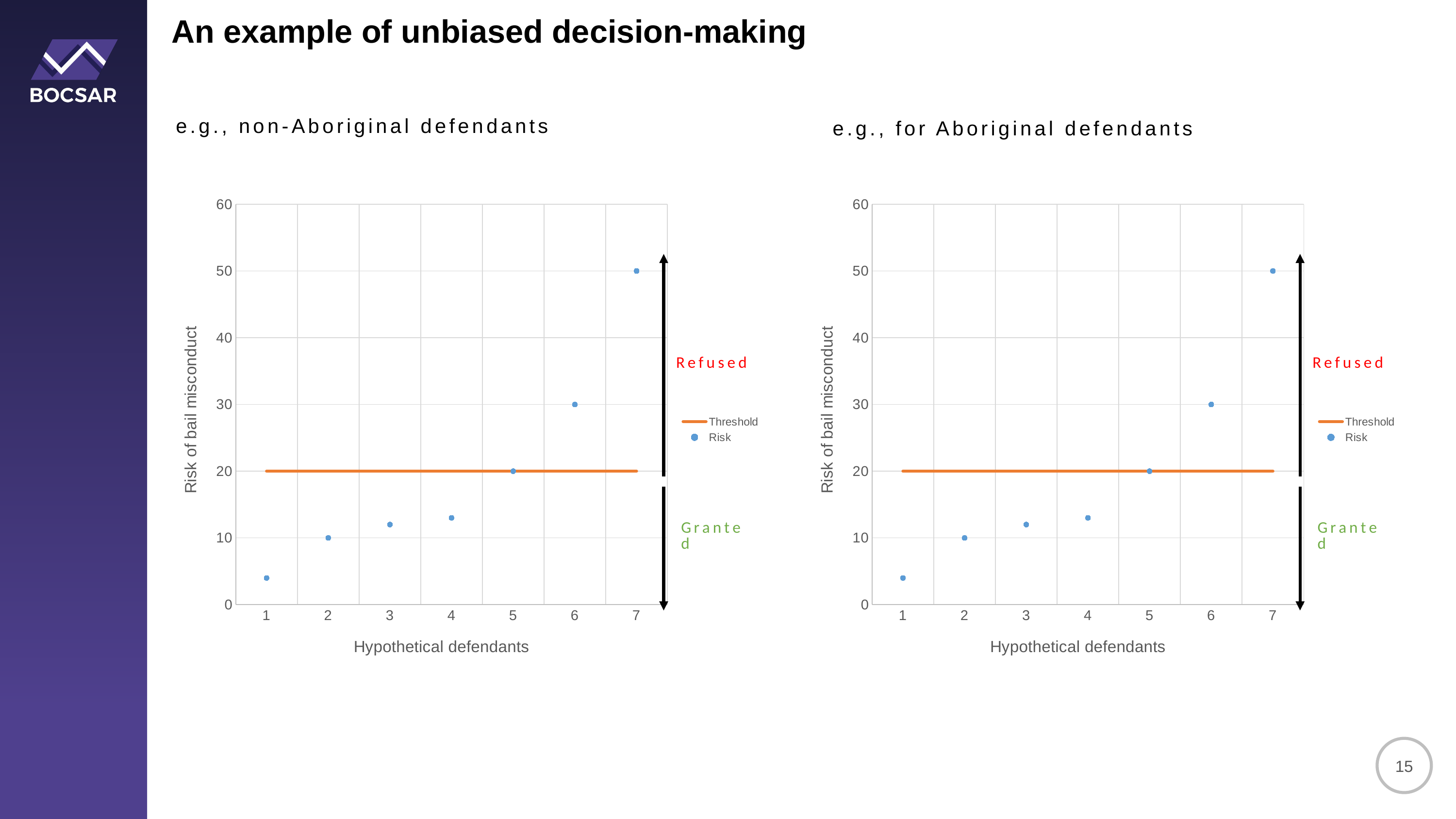
In the left chart (non-Aboriginal defendants), what is the risk of bail misconduct for hypothetical defendant 7? 50 In the left chart (non-Aboriginal defendants), at what value is the Threshold line drawn? 20 Do the risk values in the right chart (for Aboriginal defendants) rise or fall from hypothetical defendant 1 to 7? Rise How many hypothetical defendants are plotted in the right chart (for Aboriginal defendants)? 7 In the right chart (for Aboriginal defendants), what is the risk of bail misconduct for hypothetical defendant 6? 30 In the left chart (non-Aboriginal defendants), which has a higher risk value: hypothetical defendant 6 or hypothetical defendant 3? Hypothetical defendant 6 In the right chart (for Aboriginal defendants), which hypothetical defendant has the lowest risk of bail misconduct? 1 How many series does the legend of the left chart (non-Aboriginal defendants) list? 2 In the right chart (for Aboriginal defendants), what is the risk value for hypothetical defendant 2? 10 In the left chart (non-Aboriginal defendants), which hypothetical defendant has the highest risk of bail misconduct? 7 In the left chart (non-Aboriginal defendants), is the risk value for hypothetical defendant 1 greater or less than 10? less In the right chart (for Aboriginal defendants), is the risk value for hypothetical defendant 4 greater or less than 20? less